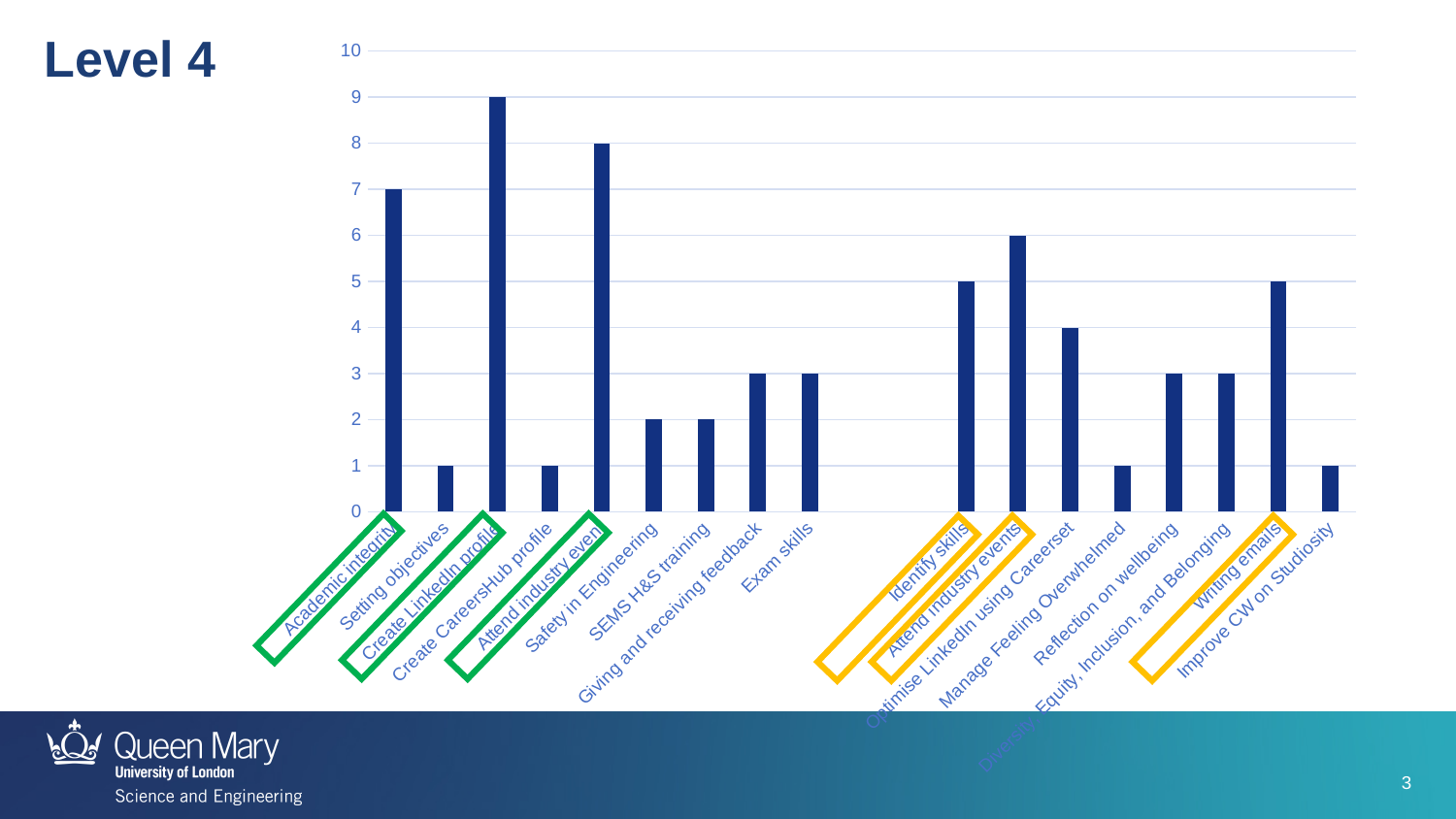
Which is larger, the value for Identify skills or the value for Exam skills? Identify skills What is the value for Create LinkedIn profile? 9 What is the highest value shown on the vertical axis? 10 What type of chart is shown on the slide? bar chart What is the value for Attend industry events (in the right-hand group)? 6 How many bars are plotted in the chart? 17 What is the value for Academic integrity? 7 Which category has the highest value? Create LinkedIn profile What is the value for Attend industry event? 8 What is the difference between the values for Create LinkedIn profile and Academic integrity? 2 Is the value for Writing emails greater or less than 3? greater What is the value for Optimise LinkedIn using Careerset? 4